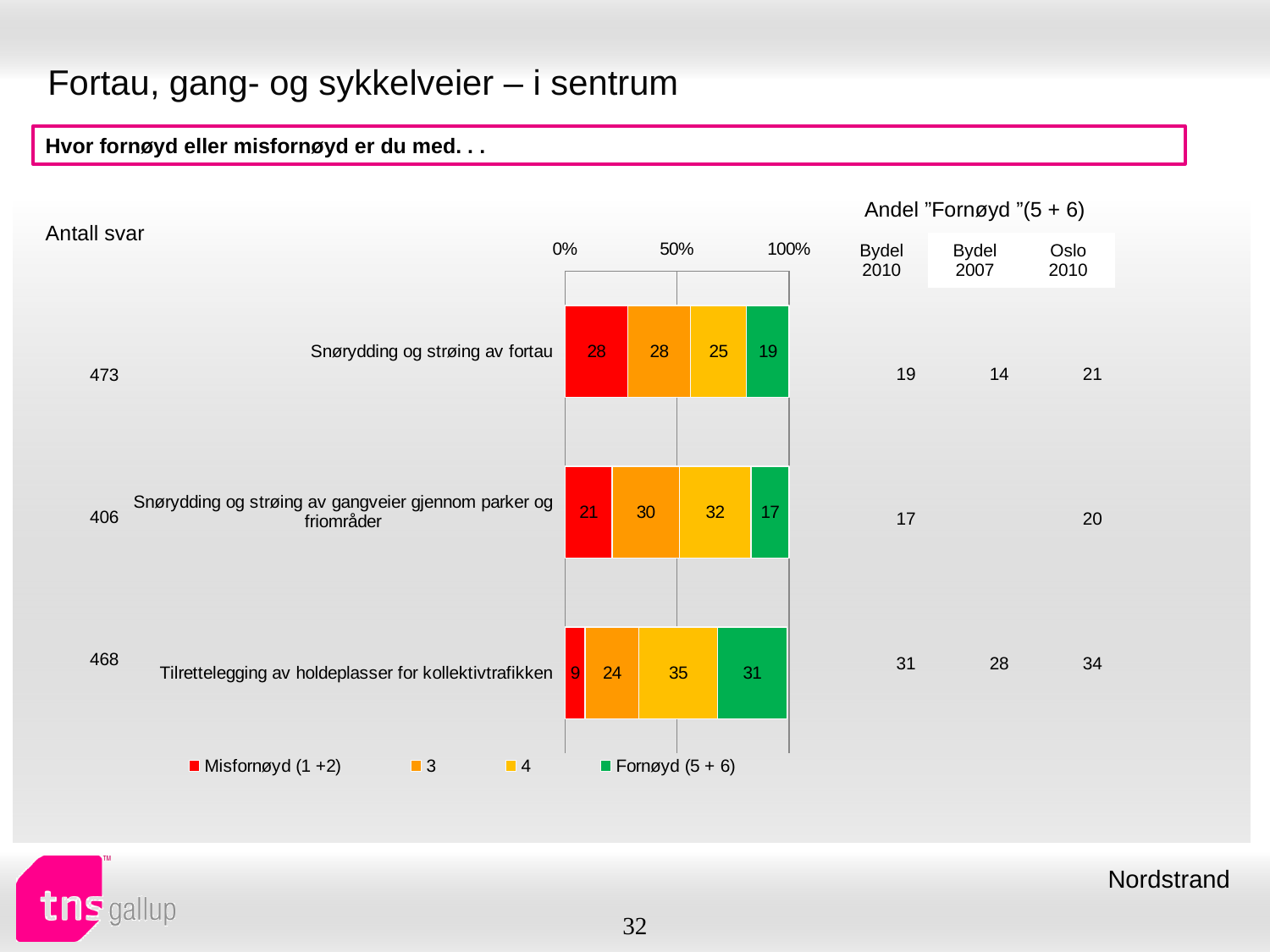
What is the total of the stacked bar for "Snørydding og strøing av fortau"? 100 Which has the larger Misfornøyd (1 +2) value: "Snørydding og strøing av fortau" or "Snørydding og strøing av gangveier gjennom parker og friområder"? Snørydding og strøing av fortau What is the difference between the Fornøyd (5 + 6) values for "Tilrettelegging av holdeplasser for kollektivtrafikken" and "Snørydding og strøing av fortau"? 12 What is the value of the Misfornøyd (1 +2) segment for "Tilrettelegging av holdeplasser for kollektivtrafikken"? 9 What is the value of the Fornøyd (5 + 6) segment for "Snørydding og strøing av fortau"? 19 Which category has the lowest Misfornøyd (1 +2) value? Tilrettelegging av holdeplasser for kollektivtrafikken What kind of chart is shown on the slide? Stacked bar chart How many series does the legend list? 4 How many categories are shown in the bar chart? 3 What is the value of the "4" segment for "Snørydding og strøing av gangveier gjennom parker og friområder"? 32 What colour represents Fornøyd (5 + 6) in the legend? Green Which category has the highest Fornøyd (5 + 6) value? Tilrettelegging av holdeplasser for kollektivtrafikken